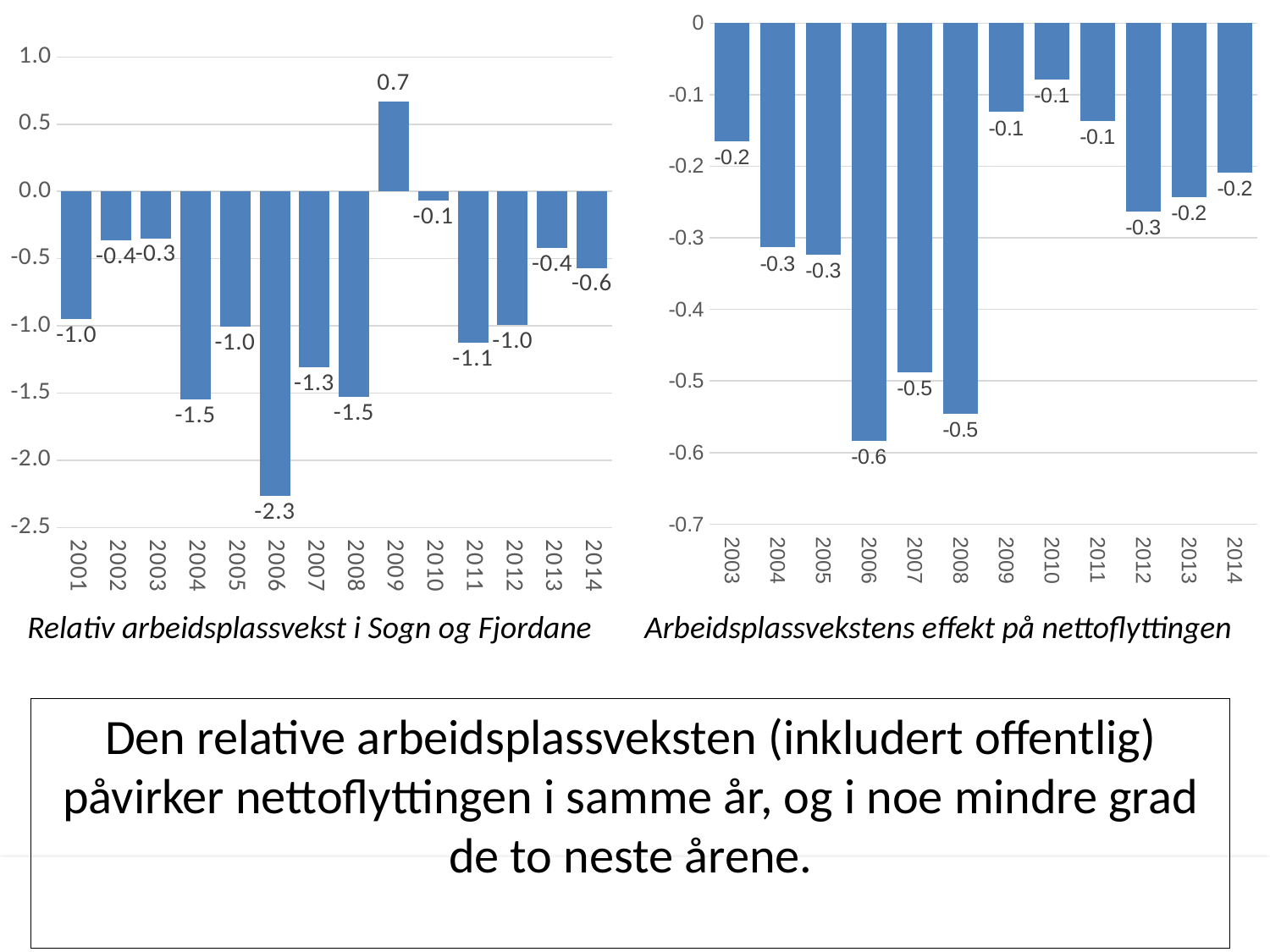
In the chart 'Arbeidsplassvekstens effekt på nettoflyttingen', what is the value for 2006? -0.6 In the chart 'Arbeidsplassvekstens effekt på nettoflyttingen', how many years are shown on the x axis? 12 In the chart 'Arbeidsplassvekstens effekt på nettoflyttingen', what is the difference between the values for 2007 and 2009? 0.4 In the chart 'Relativ arbeidsplassvekst i Sogn og Fjordane', which year has the highest value? 2009 In the chart 'Relativ arbeidsplassvekst i Sogn og Fjordane', what is the value for 2006? -2.3 In the chart 'Arbeidsplassvekstens effekt på nettoflyttingen', which year has the lowest value? 2006 In the chart 'Relativ arbeidsplassvekst i Sogn og Fjordane', what is the difference between the values for 2009 and 2006? 3.0 In the chart 'Arbeidsplassvekstens effekt på nettoflyttingen', which is larger, the value for 2003 or the value for 2004? 2003 In the chart 'Relativ arbeidsplassvekst i Sogn og Fjordane', what is the value for 2009? 0.7 In the chart 'Relativ arbeidsplassvekst i Sogn og Fjordane', which year has the lowest value? 2006 In the chart 'Relativ arbeidsplassvekst i Sogn og Fjordane', how many years are shown on the x axis? 14 What kind of chart is 'Relativ arbeidsplassvekst i Sogn og Fjordane'? Bar chart